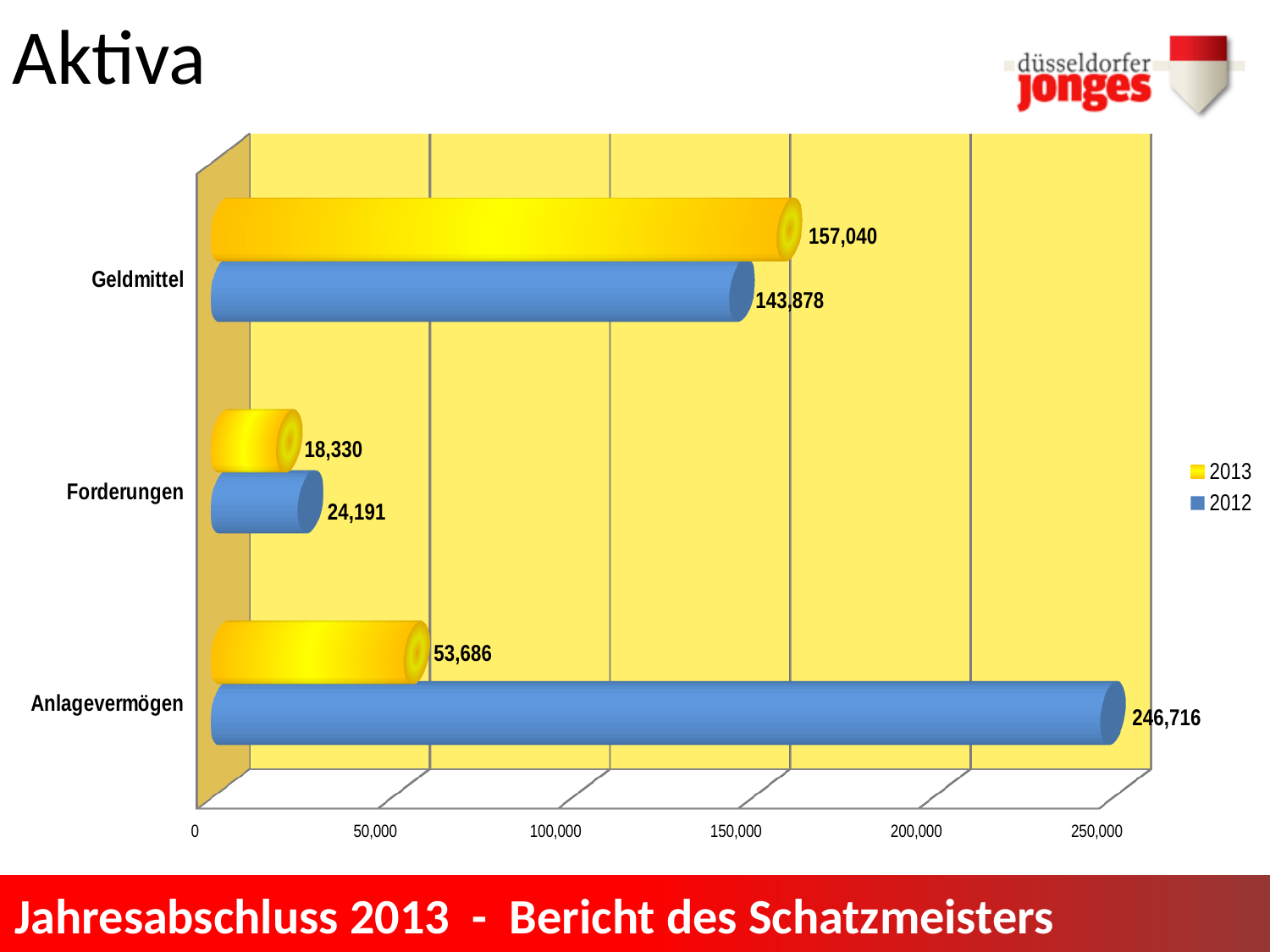
Which category has the highest value in the 2013 series? Geldmittel What is the value for Anlagevermögen in 2012? 246,716 What is the difference between the 2013 and 2012 values for Geldmittel? 13,162 Is the 2013 value for Anlagevermögen greater or less than 100,000? less What is the value for Forderungen in 2012? 24,191 How many categories are shown on the chart? 3 What is the difference between the 2012 and 2013 values for Anlagevermögen? 193,030 What kind of chart is shown on the slide? bar chart What is the value for Geldmittel in 2013? 157,040 Which category has the lowest value in the 2012 series? Forderungen Which is larger for Forderungen, the 2013 value or the 2012 value? 2012 How many series does the legend list? 2